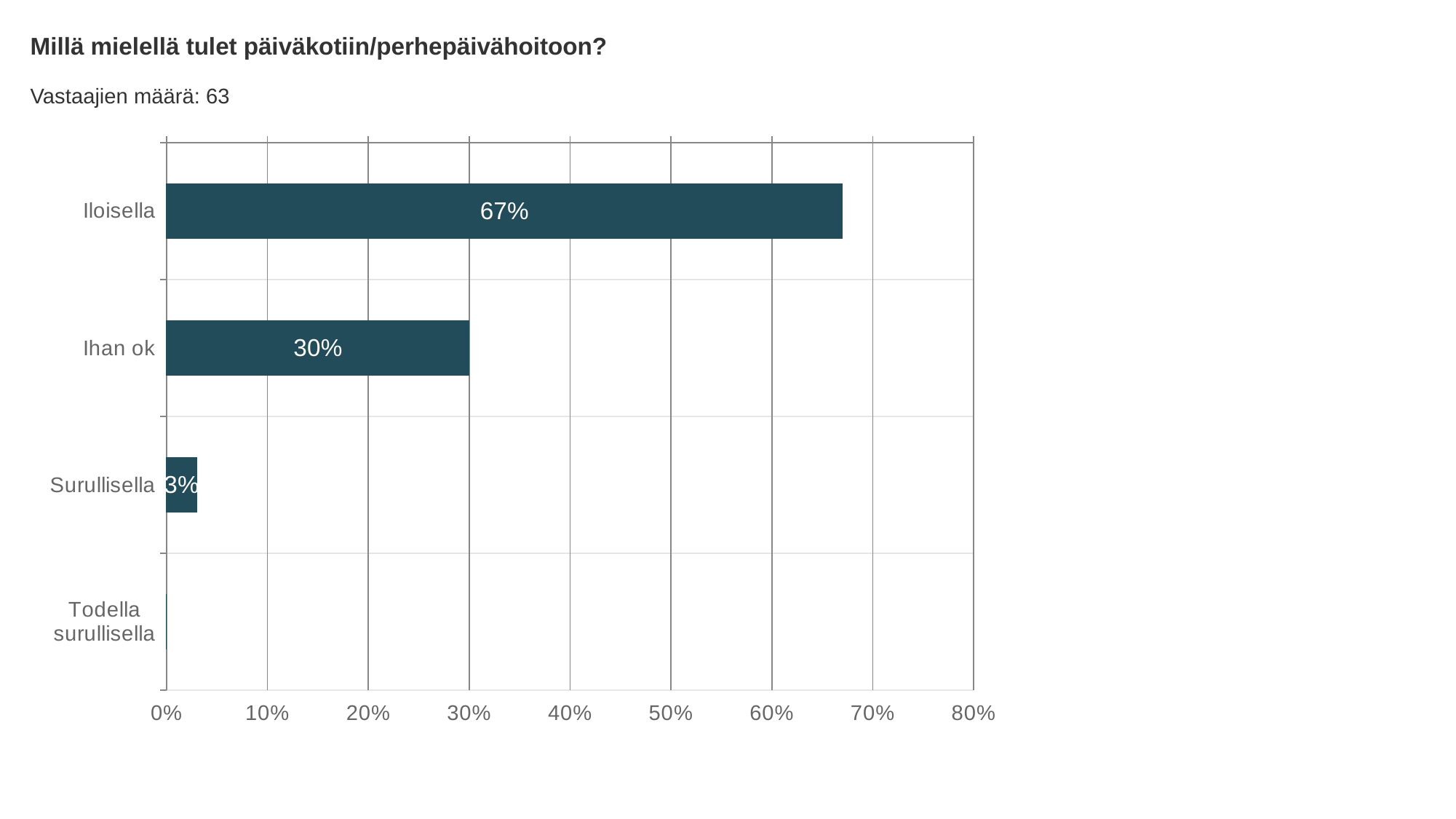
What is the value for Surullisella? 3% Which category has the highest value? Iloisella What is the title of the chart? Millä mielellä tulet päiväkotiin/perhepäivähoitoon? What is the difference between the values for Iloisella and Ihan ok? 37% What is the value for Ihan ok? 30% Which category has the lowest value? Todella surullisella What kind of chart is shown on the slide? bar chart Is the value for Iloisella greater or less than 60%? greater How many respondents (Vastaajien määrä) does the slide report? 63 How many categories are shown on the chart? 4 What is the value for Iloisella? 67% Which is larger, the value for Ihan ok or the value for Surullisella? Ihan ok